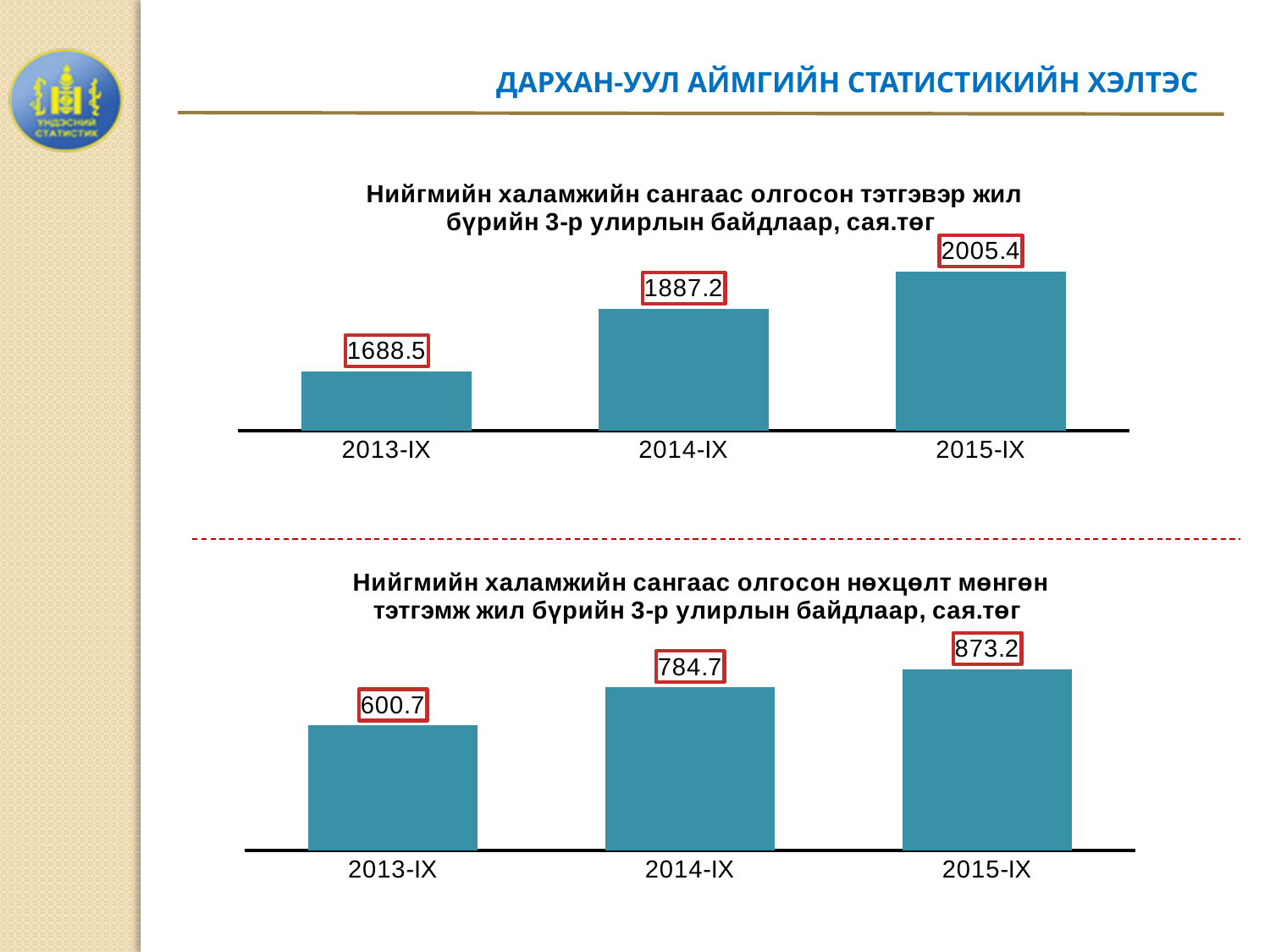
In the bottom chart, which is larger, the value for 2014-IX or 2015-IX? 2015-IX In the top chart, what is the difference between the 2015-IX and 2013-IX values? 316.9 In the bottom chart, what is the difference between the 2014-IX and 2013-IX values? 184.0 In the top chart, do the values rise or fall from 2013-IX to 2015-IX? rise In the bottom chart, which year has the lowest value? 2013-IX In the top chart, which year has the highest value? 2015-IX How many bars does the bottom chart have? 3 In the bottom chart, what is the value for 2015-IX? 873.2 In the bottom chart, what is the value for 2013-IX? 600.7 In the top chart, what is the value for 2013-IX? 1688.5 What type of chart is the top chart? bar chart In the top chart, what is the value for 2014-IX? 1887.2